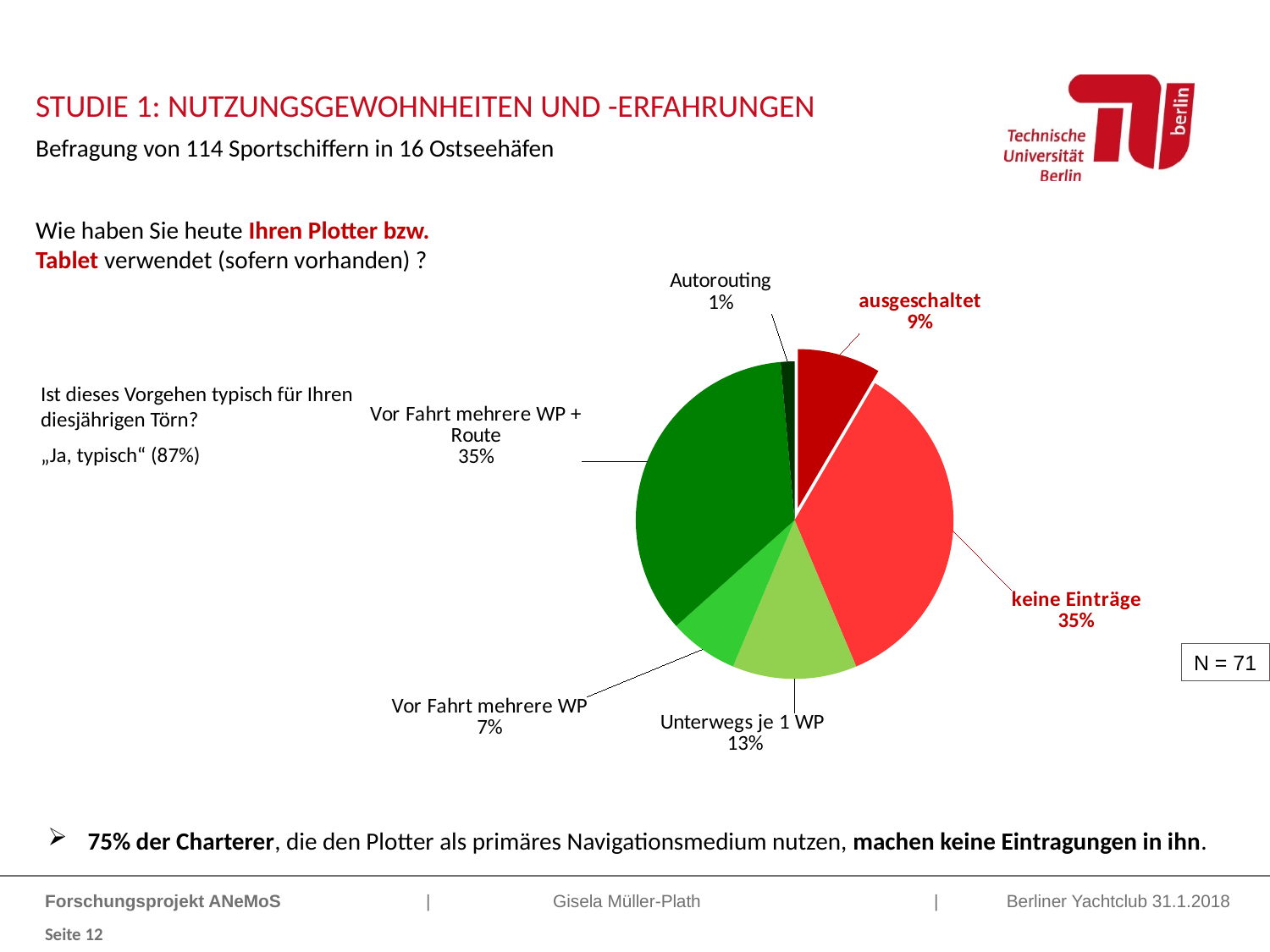
What share of the pie does "ausgeschaltet" have? 9% What share of the pie does "keine Einträge" have? 35% Which is larger, "ausgeschaltet" or "Vor Fahrt mehrere WP"? ausgeschaltet What sample size (N) is shown next to the pie chart? N = 71 What share of the pie does "Vor Fahrt mehrere WP" have? 7% How many slices does the pie chart have? 6 Which slice of the pie is the smallest? Autorouting What share of the pie does "Vor Fahrt mehrere WP + Route" have? 35% What kind of chart is shown on the slide? pie chart What is the difference in percentage points between "keine Einträge" and "Unterwegs je 1 WP"? 22 What share of the pie does "Unterwegs je 1 WP" have? 13% What is the difference in percentage points between "ausgeschaltet" and "Autorouting"? 8